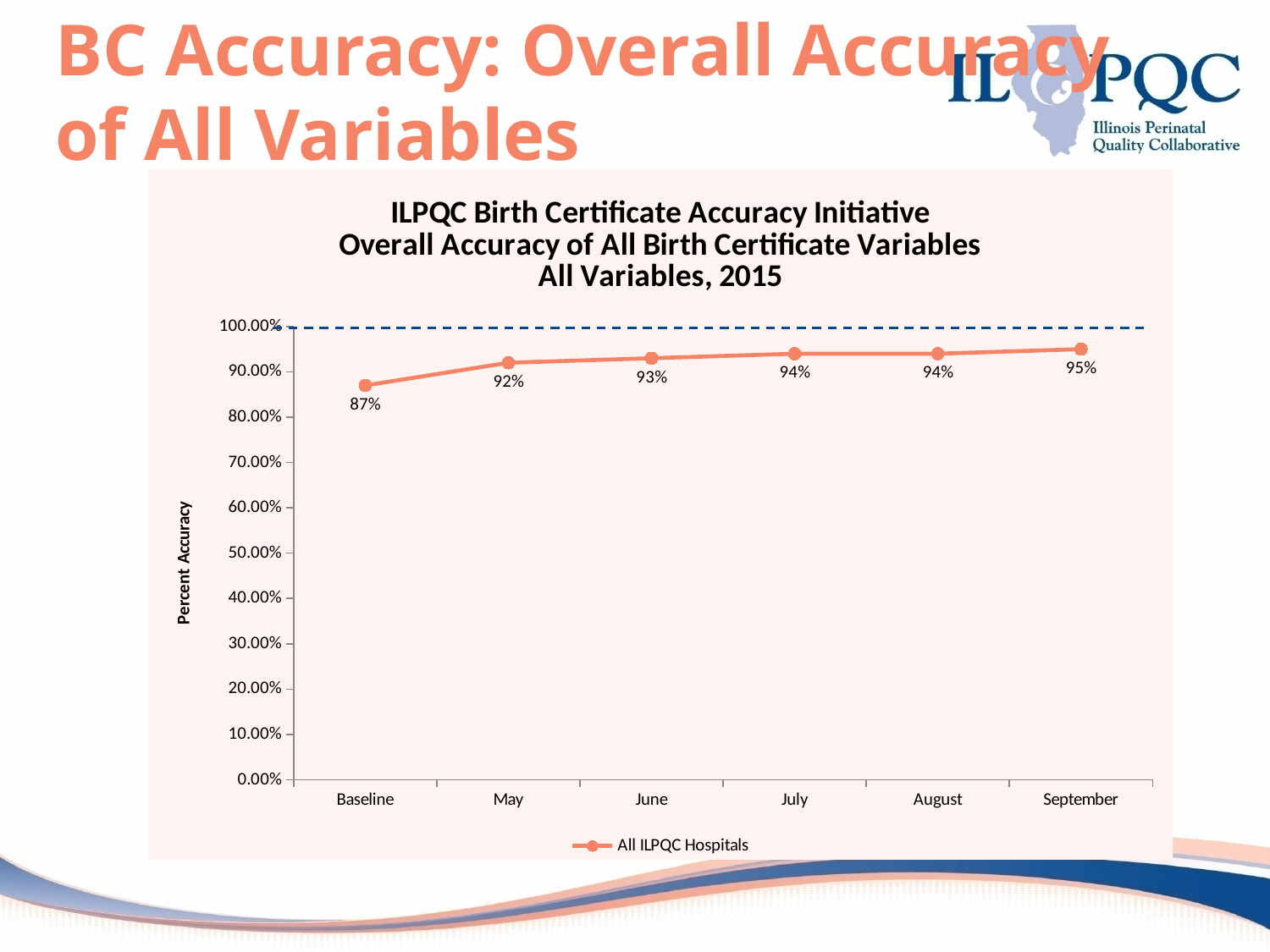
What is the value for September? 95% Do the values rise or fall from Baseline to September? rise How many categories are shown on the x axis? 6 What is the difference between the September value and the Baseline value? 8% Which category has the highest value? September Which is larger, the value for May or the value for Baseline? May What is the value for June? 93% Is the value for Baseline greater or less than 80.00%? greater What is the value for Baseline? 87% What kind of chart is this? line chart How many series does the legend list? 1 Which category has the lowest value? Baseline